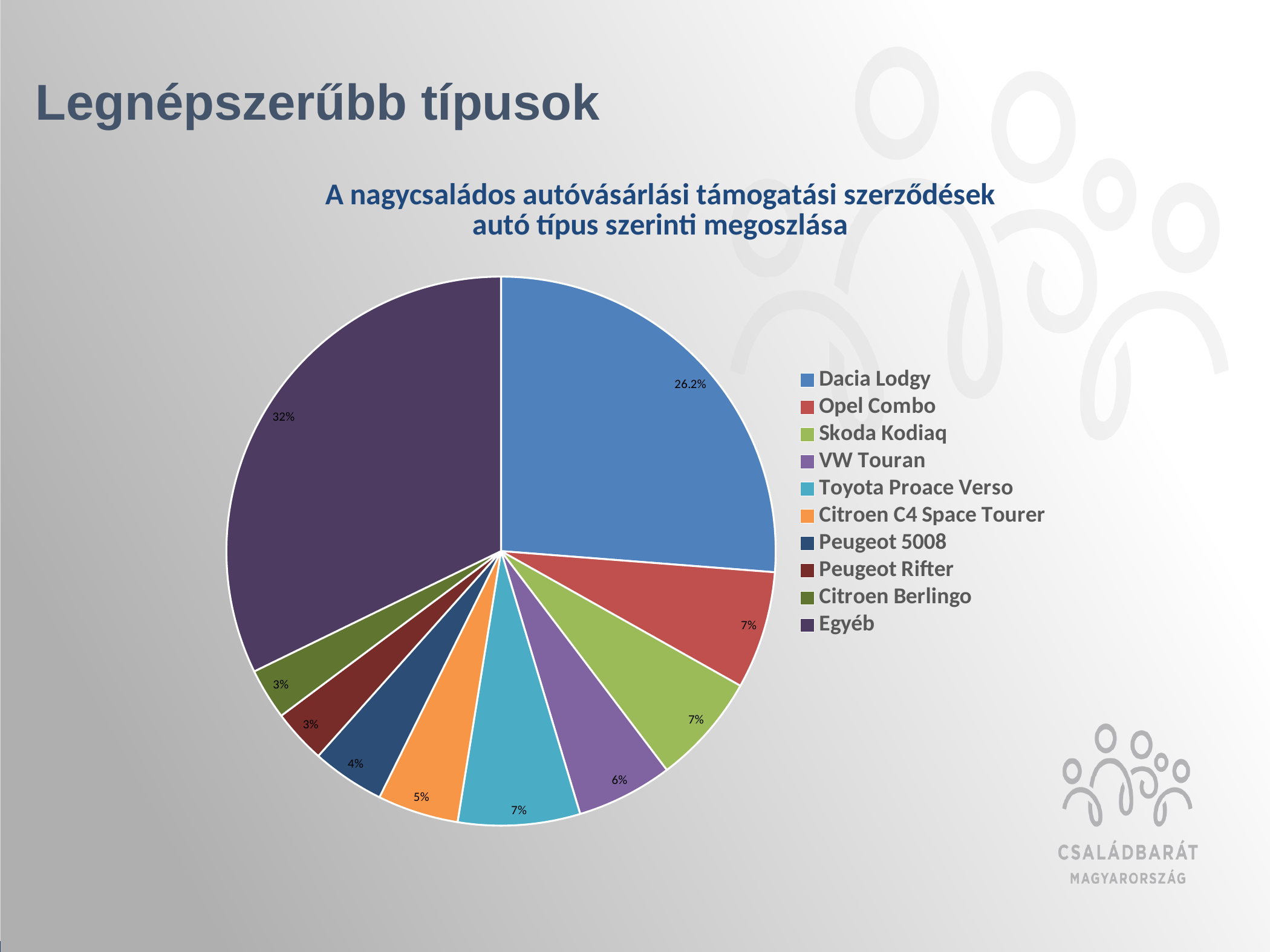
What is the value shown for Peugeot 5008? 4% What share of the pie does Egyéb have? 32% Which is larger, the slice for Dacia Lodgy or the slice for Opel Combo? Dacia Lodgy What is the difference between the Egyéb share and the Dacia Lodgy share? 5.8% What is the difference between the Toyota Proace Verso share and the Peugeot 5008 share? 3% What colour is the slice for Citroen C4 Space Tourer? orange Which category has the largest slice of the pie? Egyéb What share of the pie does Dacia Lodgy have? 26.2% What is the value shown for Citroen C4 Space Tourer? 5% How many categories does the legend list? 10 What type of chart is shown on the slide? pie chart What is the value shown for VW Touran? 6%